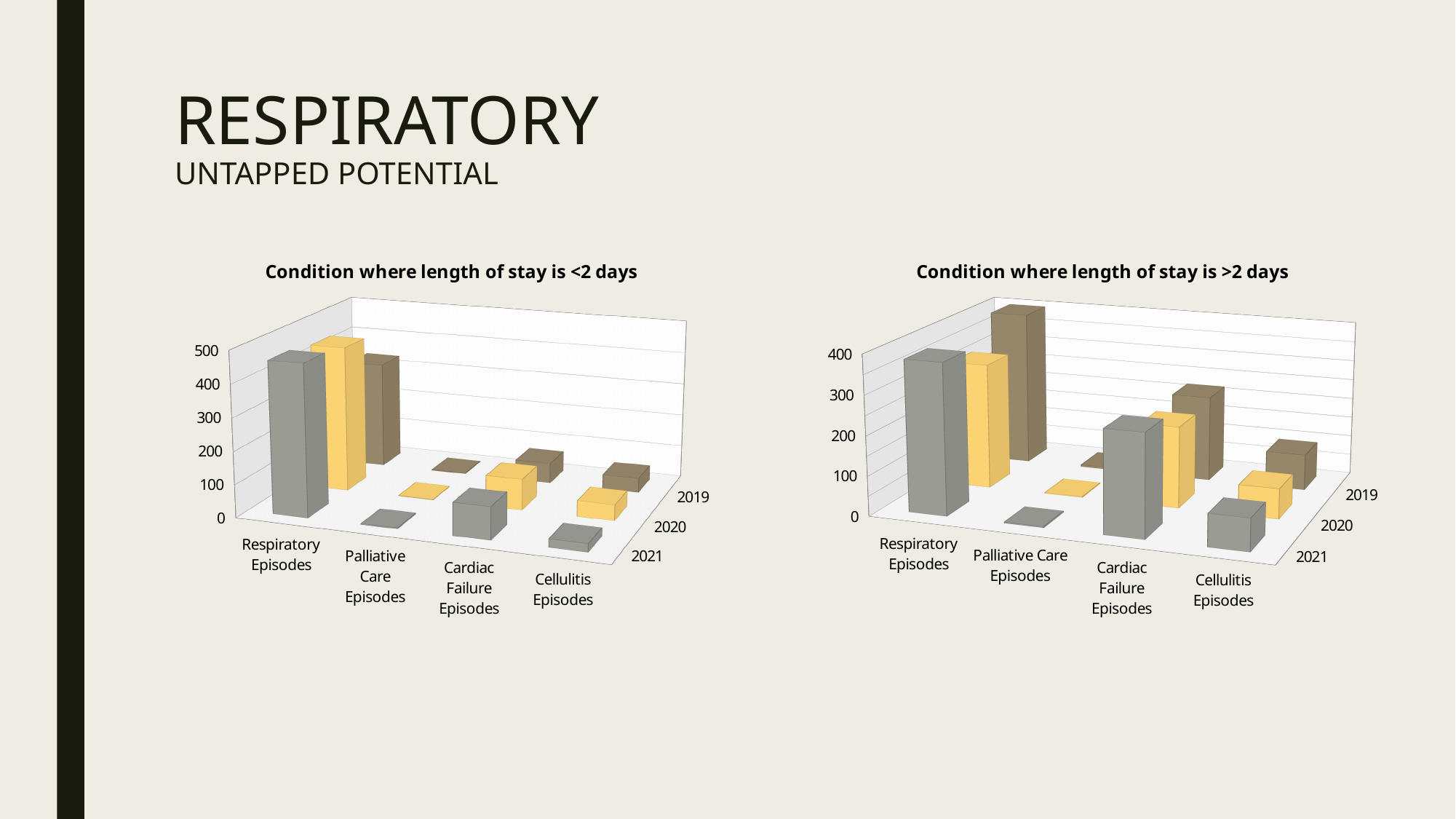
In the 'Condition where length of stay is >2 days' chart, which is larger: Respiratory Episodes in 2021 or Cardiac Failure Episodes in 2021? Respiratory Episodes in 2021 In the 'Condition where length of stay is >2 days' chart, which condition has the highest bars? Respiratory Episodes In the 'Condition where length of stay is >2 days' chart, which condition has the lowest bars? Palliative Care Episodes In the 'Condition where length of stay is <2 days' chart, is the value for Palliative Care Episodes in 2021 greater or less than 100? less In the 'Condition where length of stay is >2 days' chart, is the value for Cellulitis Episodes in 2021 greater or less than 200? less In the 'Condition where length of stay is <2 days' chart, which condition has the highest bars? Respiratory Episodes What is the highest value shown on the vertical axis of the 'Condition where length of stay is >2 days' chart? 400 How many years are plotted in the 'Condition where length of stay is <2 days' chart? 3 How many condition categories are shown on the x axis of the 'Condition where length of stay is >2 days' chart? 4 What kind of chart is the 'Condition where length of stay is <2 days' chart? bar chart In the 'Condition where length of stay is <2 days' chart, is the value for Respiratory Episodes in 2021 greater or less than 300? greater In the 'Condition where length of stay is <2 days' chart, which condition has the lowest bars? Palliative Care Episodes